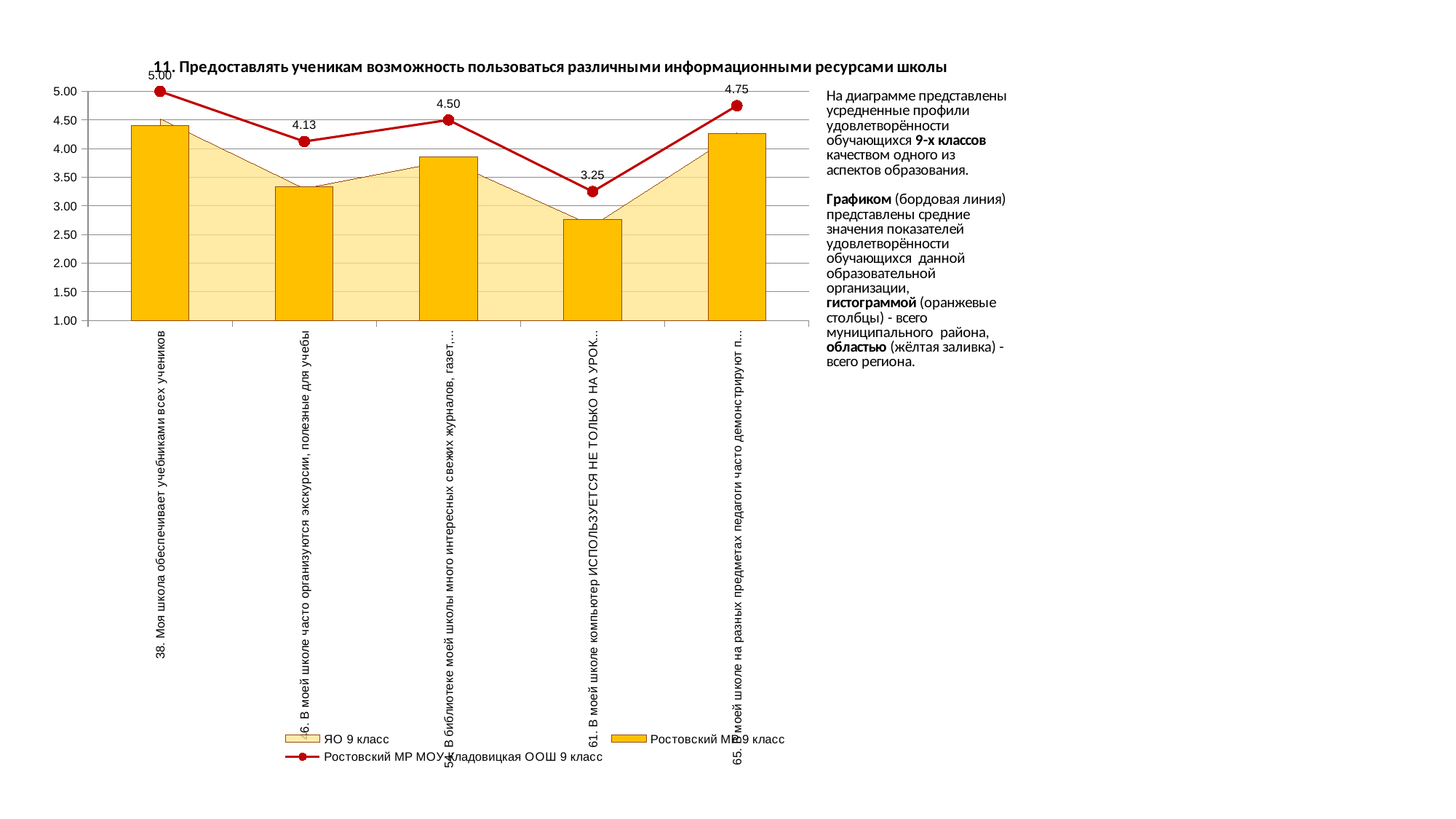
For which item does the 'Ростовский МР МОУ Кладовицкая ООШ 9 класс' line reach its highest value? 38. Моя школа обеспечивает учебниками всех учеников How many series does the legend list? 3 What is the value of the red line for item 61 (В моей школе компьютер используется не только на уроках)? 3.25 How many items (categories) are shown on the x axis? 5 What is the value of the 'Ростовский МР МОУ Кладовицкая ООШ 9 класс' line for item 38 (Моя школа обеспечивает учебниками всех учеников)? 5.00 Is the orange bar for item 38 greater or less than 4.00? greater For which item does the red line have its lowest value? 61. В моей школе компьютер используется не только на уроках What kind of chart is used to show the series 'Ростовский МР 9 класс'? bar chart Which has a larger value on the red line: item 54 or item 65? Item 65 (4.75) What is the difference between the highest and lowest values of the red line (5.00 and 3.25)? 1.75 What is the value of the 'Ростовский МР МОУ Кладовицкая ООШ 9 класс' line for item 46 (В моей школе часто организуются экскурсии, полезные для учебы)? 4.13 Is the orange bar for item 61 greater or less than 3.00? less